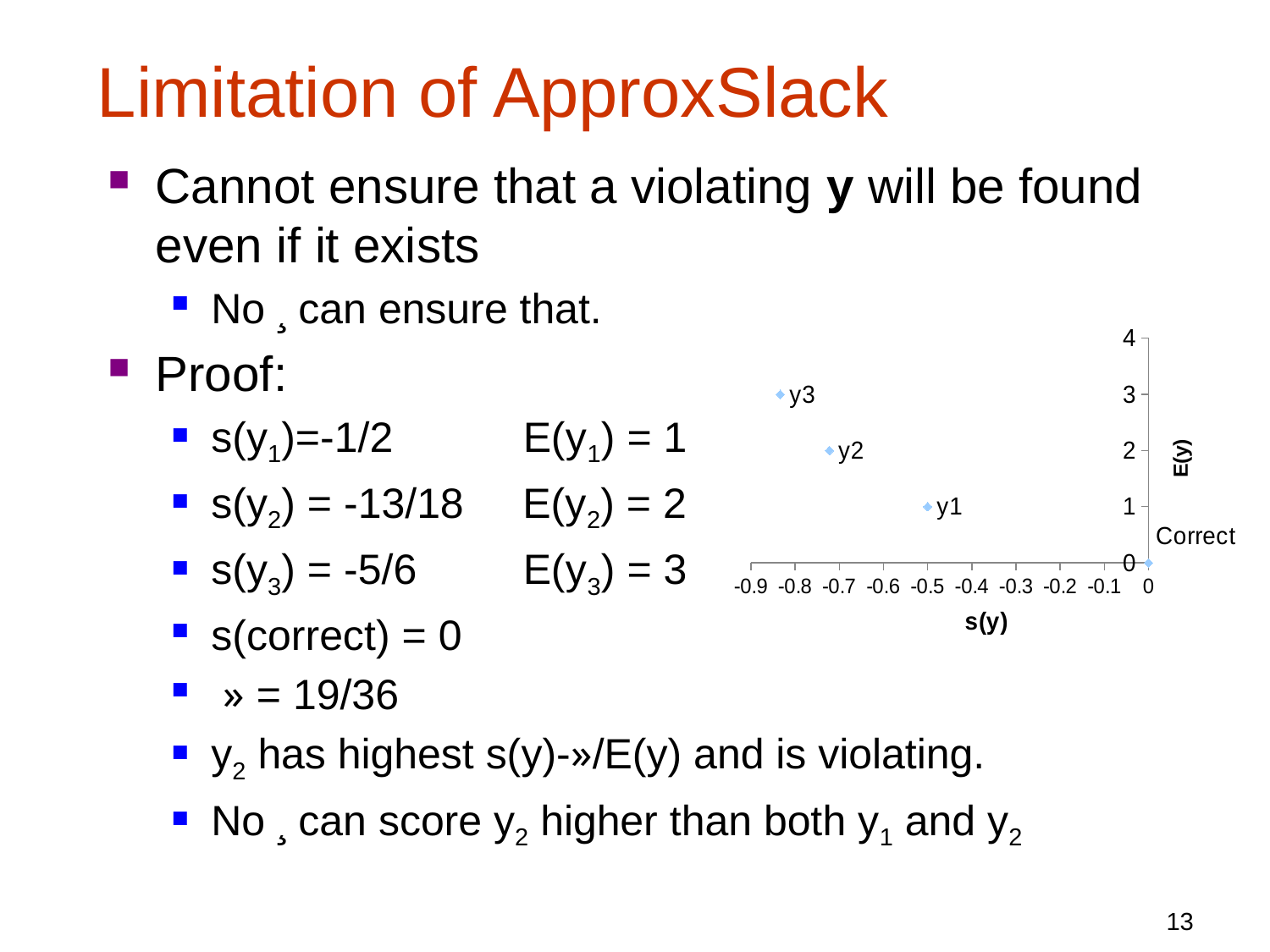
What is the E(y) value of the point labelled y1? 1 Is the s(y) value for y2 greater or less than -0.6? less How many data points are plotted in the chart? 4 What kind of chart is shown on the slide? scatter chart What is the s(y) value of the point labelled y1? -0.5 Which point has a larger E(y) value, y1 or y2? y2 Moving from left to right along the s(y) axis, do the E(y) values of the points rise or fall? fall What is the difference between the E(y) values of y3 and y1? 2 Which labelled point has the lowest s(y) value? y3 What is the title of the horizontal axis of the chart? s(y) What is the E(y) value of the point labelled y3? 3 Which labelled point has the highest E(y) value? y3